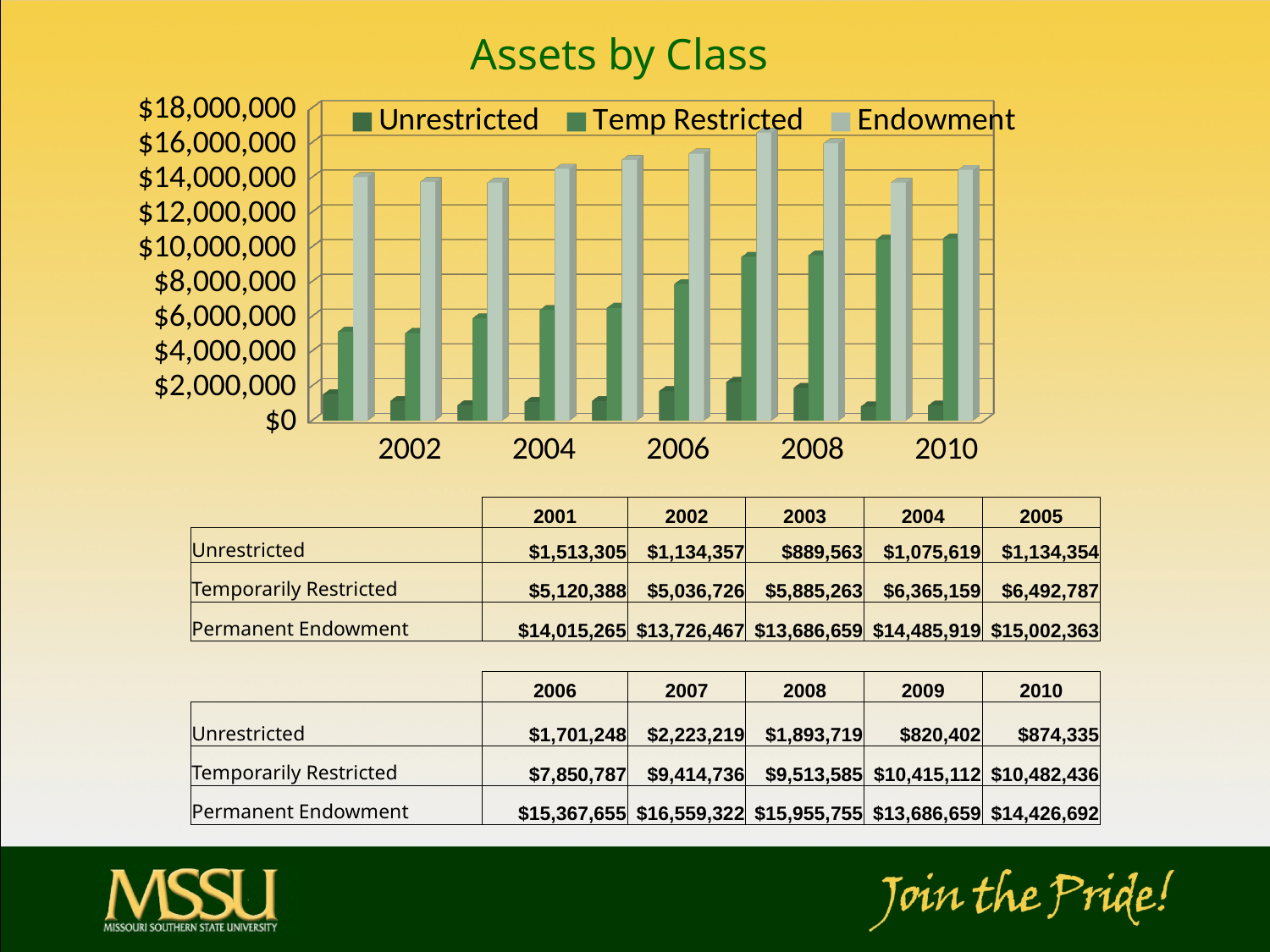
What is the Temporarily Restricted value for 2008? $9,513,585 How many series does the chart legend list? 3 Which is larger, the Endowment value for 2007 or for 2008? 2007 In which year is the Unrestricted value lowest? 2009 What is the difference between the Temporarily Restricted values for 2010 and 2001? $5,362,048 What kind of chart is shown on the slide? bar chart What is the title of the chart? Assets by Class Is the Temp Restricted value for 2010 greater or less than $10,000,000? greater What is the Unrestricted value for 2006? $1,701,248 What is the Permanent Endowment value for 2003? $13,686,659 In which year is the Endowment value highest? 2007 How many years are plotted on the chart? 10